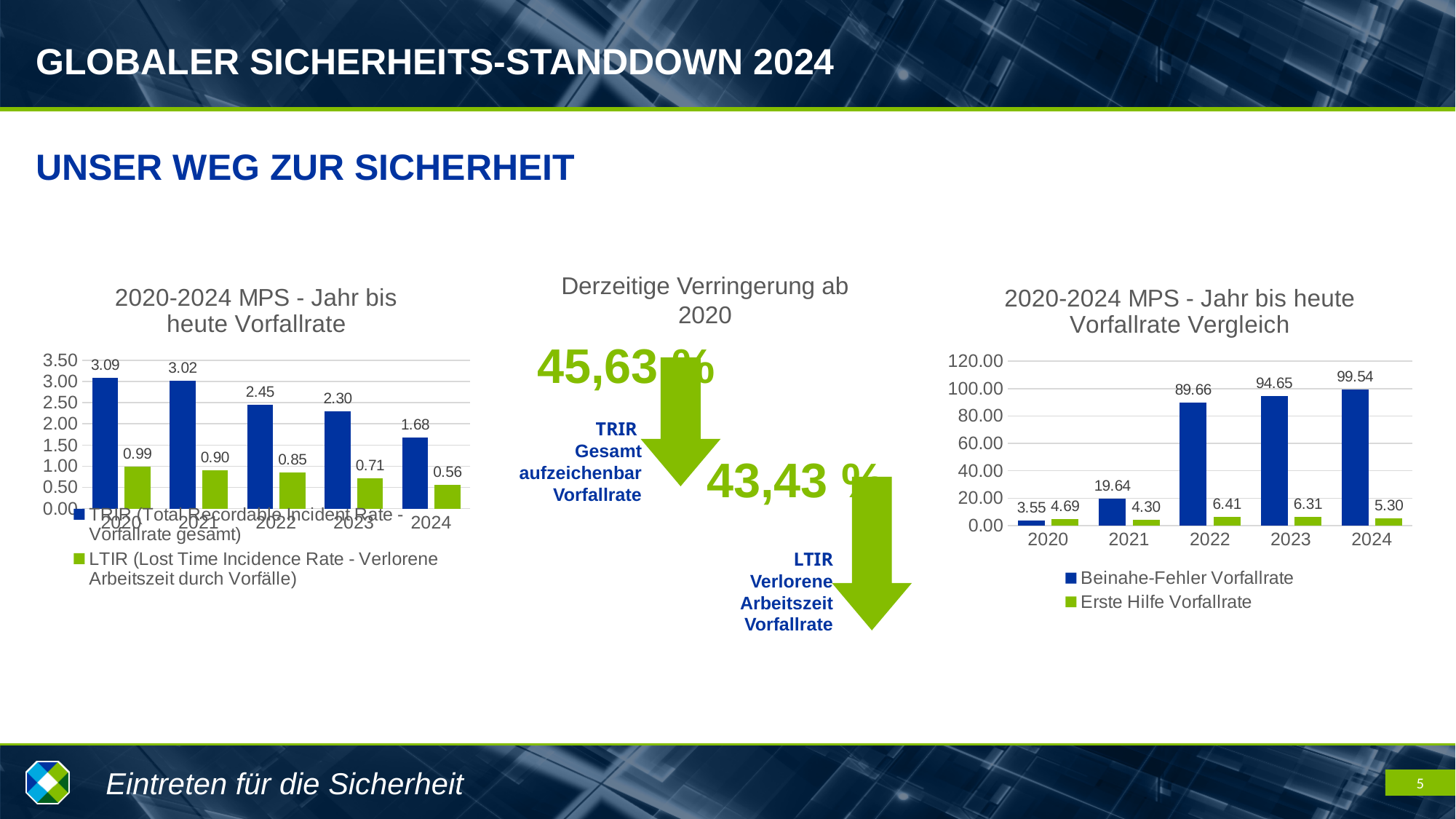
In the left chart '2020-2024 MPS - Jahr bis heute Vorfallrate', which year has the highest TRIR value? 2020 In the left chart '2020-2024 MPS - Jahr bis heute Vorfallrate', do the TRIR values rise or fall from 2020 to 2024? fall In the right chart '2020-2024 MPS - Jahr bis heute Vorfallrate Vergleich', what is the Erste Hilfe Vorfallrate for 2021? 4.30 In the left chart '2020-2024 MPS - Jahr bis heute Vorfallrate', what is the LTIR value for 2024? 0.56 In the right chart '2020-2024 MPS - Jahr bis heute Vorfallrate Vergleich', how many years are shown on the x axis? 5 In the left chart '2020-2024 MPS - Jahr bis heute Vorfallrate', what is the difference between the TRIR values for 2020 and 2024? 1.41 In the right chart '2020-2024 MPS - Jahr bis heute Vorfallrate Vergleich', what is the Beinahe-Fehler Vorfallrate for 2023? 94.65 In the left chart '2020-2024 MPS - Jahr bis heute Vorfallrate', how many series does the legend list? 2 What kind of chart is the right chart '2020-2024 MPS - Jahr bis heute Vorfallrate Vergleich'? bar chart In the right chart '2020-2024 MPS - Jahr bis heute Vorfallrate Vergleich', which is larger in 2020: the Beinahe-Fehler Vorfallrate or the Erste Hilfe Vorfallrate? Erste Hilfe Vorfallrate In the left chart '2020-2024 MPS - Jahr bis heute Vorfallrate', what is the TRIR value for 2022? 2.45 In the right chart '2020-2024 MPS - Jahr bis heute Vorfallrate Vergleich', which year has the lowest Beinahe-Fehler Vorfallrate? 2020